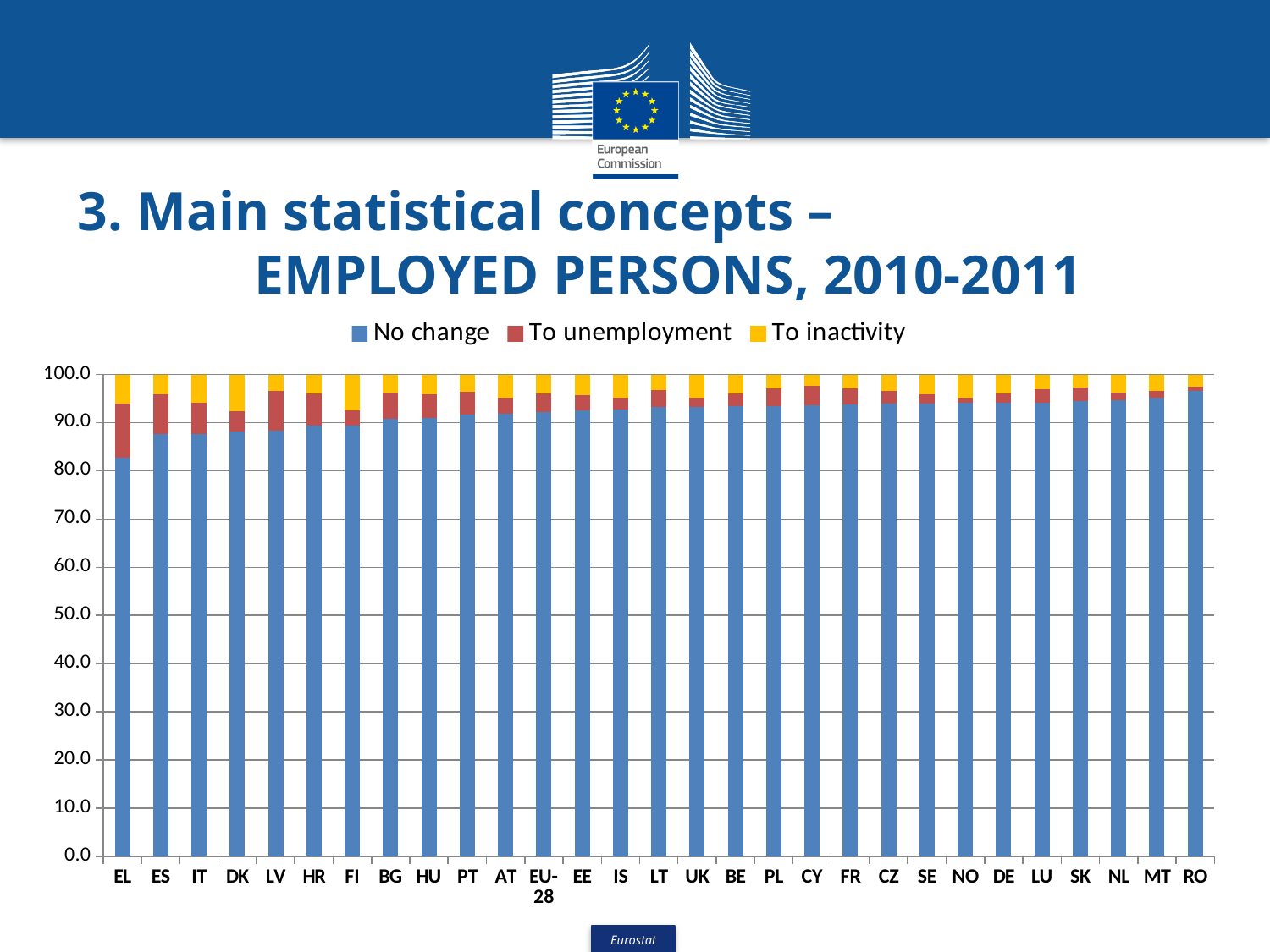
Is the 'No change' value for ES greater or less than 90.0? less Which category has the lowest 'No change' value? EL How many countries/categories are shown on the x axis? 29 Which colour represents 'To inactivity' in the legend? Yellow Is the 'No change' value for RO greater or less than 90.0? greater How many series does the legend list? 3 What is the total height of the stacked bar for EL? 100.0 Which has a larger 'No change' value, EL or RO? RO Which category has the highest 'No change' value? RO Is the 'No change' value for EL greater or less than 90.0? less Does the 'No change' share rise or fall moving from left to right along the x axis? Rise What kind of chart is shown on the slide? Stacked bar chart